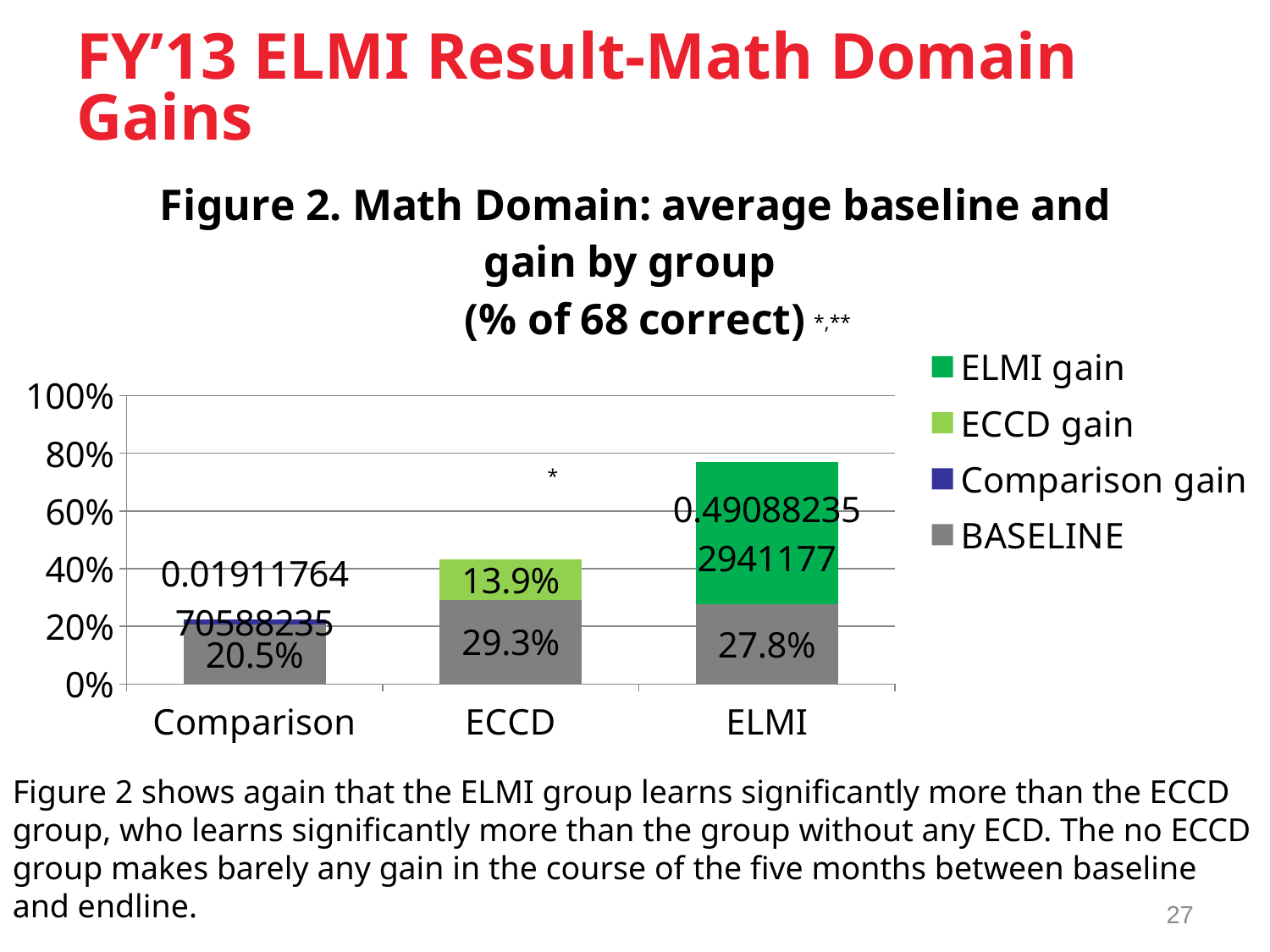
How many groups are shown on the x axis? 3 What is the BASELINE value for the ECCD group? 29.3% What is the difference between the ECCD and ELMI BASELINE values? 1.5% How many series does the legend list? 4 Which is larger, the BASELINE value for ECCD or for ELMI? ECCD Is the total height of the ELMI bar greater or less than 60%? greater What is the BASELINE value for the Comparison group? 20.5% What is the ECCD gain value shown on the ECCD bar? 13.9% Which group has the highest BASELINE value? ECCD Which group has the lowest BASELINE value? Comparison What is the BASELINE value for the ELMI group? 27.8% What is the total of the ECCD stacked bar (BASELINE plus ECCD gain)? 43.2%